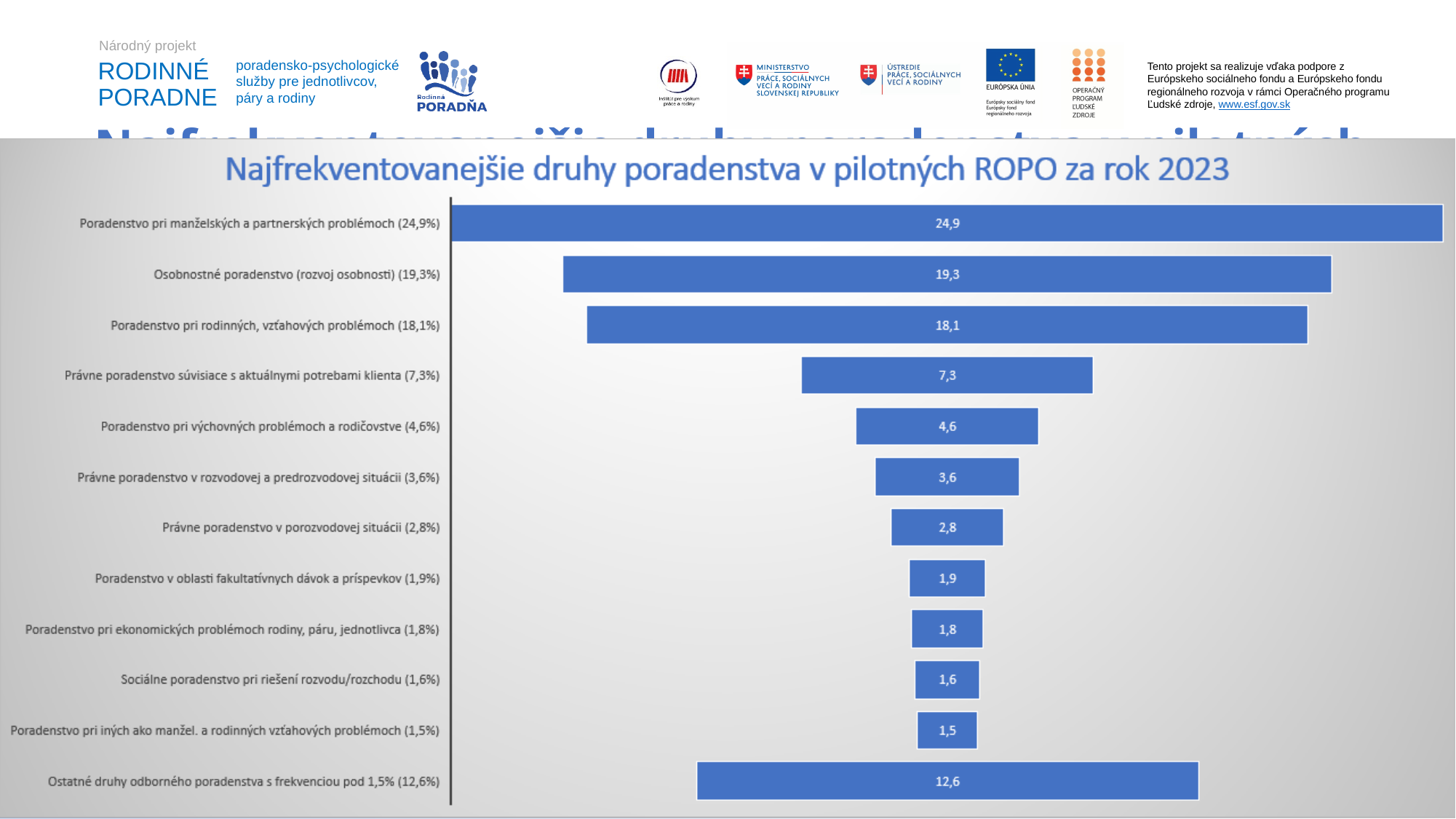
How many categories are plotted in the chart? 12 What is the value for 'Ostatné druhy odborného poradenstva s frekvenciou pod 1,5%'? 12,6 Which category has the highest value? Poradenstvo pri manželských a partnerských problémoch What is the value for 'Osobnostné poradenstvo (rozvoj osobnosti)'? 19,3 Which is larger: the value for 'Poradenstvo pri výchovných problémoch a rodičovstve' or 'Právne poradenstvo v rozvodovej a predrozvodovej situácii'? Poradenstvo pri výchovných problémoch a rodičovstve What colour are the bars in the chart? Blue What is the difference between the values for 'Poradenstvo pri rodinných, vzťahových problémoch' and 'Ostatné druhy odborného poradenstva s frekvenciou pod 1,5%'? 5,5 What is the value for 'Právne poradenstvo súvisiace s aktuálnymi potrebami klienta'? 7,3 What type of chart is shown on the slide? Bar chart Which category has the lowest value? Poradenstvo pri iných ako manžel. a rodinných vzťahových problémoch What is the difference between the values for 'Poradenstvo pri manželských a partnerských problémoch' and 'Osobnostné poradenstvo (rozvoj osobnosti)'? 5,6 What is the title of the chart? Najfrekventovanejšie druhy poradenstva v pilotných ROPO za rok 2023